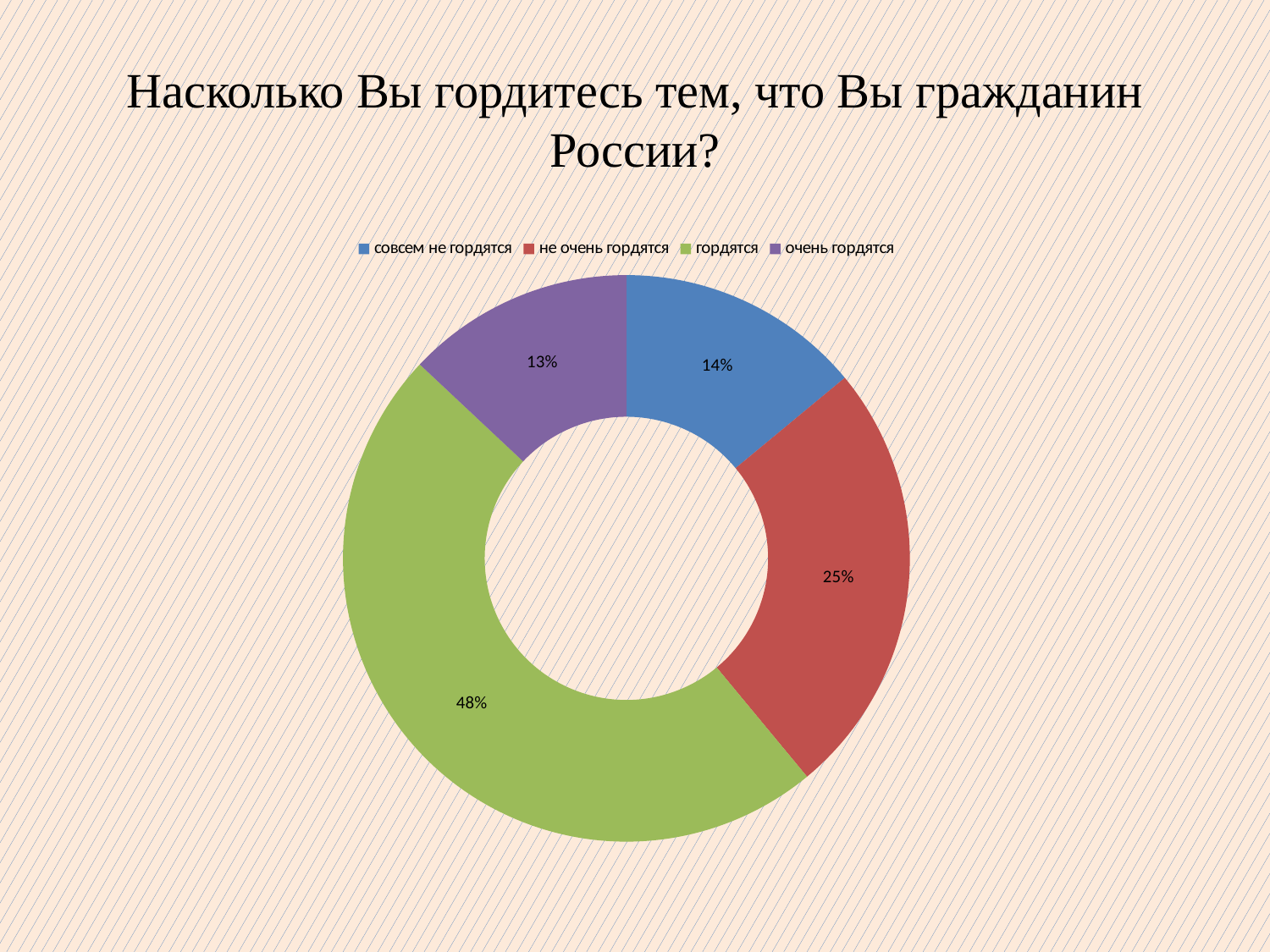
What share of respondents answered "очень гордятся"? 13% Which is larger: the share for "не очень гордятся" or the share for "совсем не гордятся"? не очень гордятся Which response category has the smallest share? очень гордятся What share of respondents answered "гордятся"? 48% How many response categories are shown in the chart? 4 Which response category has the largest share? гордятся What is the difference in percentage points between "гордятся" and "не очень гордятся"? 23 What share of respondents answered "совсем не гордятся"? 14% How many entries does the legend list? 4 What kind of chart is shown on the slide? Doughnut (pie) chart What colour is the segment for "гордятся"? Green What share of respondents answered "не очень гордятся"? 25%